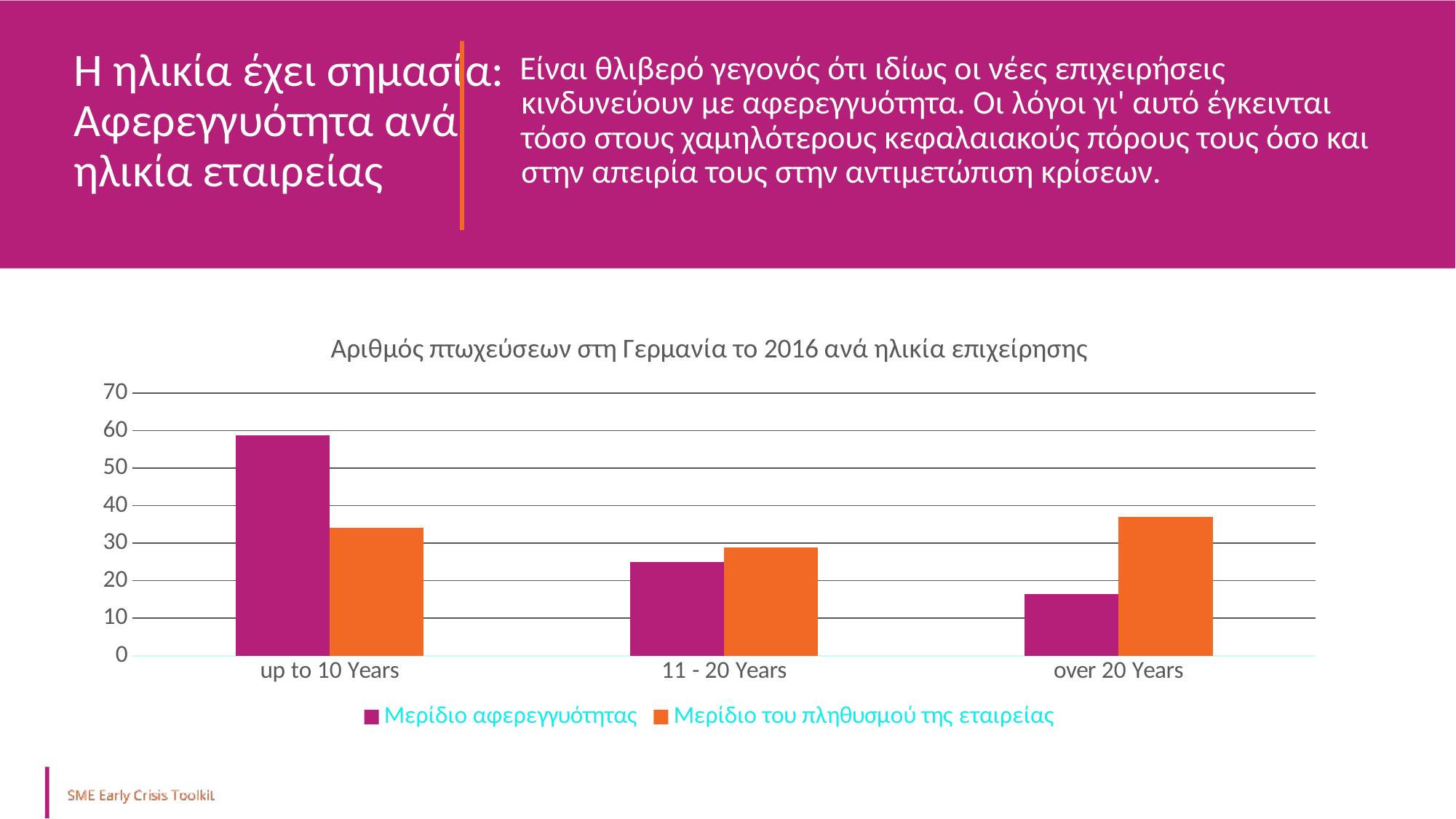
Which category has the lowest value for Μερίδιο του πληθυσμού της εταιρείας? 11 - 20 Years How many age categories are shown on the x axis? 3 What is the title of the chart? Αριθμός πτωχεύσεων στη Γερμανία το 2016 ανά ηλικία επιχείρησης What kind of chart is shown on the slide? bar chart Does the value for Μερίδιο αφερεγγυότητας rise or fall across the categories from up to 10 Years to over 20 Years? fall Is the value for Μερίδιο αφερεγγυότητας for up to 10 Years greater or less than 50? greater For over 20 Years, which series has the larger value: Μερίδιο αφερεγγυότητας or Μερίδιο του πληθυσμού της εταιρείας? Μερίδιο του πληθυσμού της εταιρείας For up to 10 Years, which series has the larger value: Μερίδιο αφερεγγυότητας or Μερίδιο του πληθυσμού της εταιρείας? Μερίδιο αφερεγγυότητας Which category has the lowest value for Μερίδιο αφερεγγυότητας? over 20 Years Which category has the highest value for Μερίδιο αφερεγγυότητας? up to 10 Years Which category has the highest value for Μερίδιο του πληθυσμού της εταιρείας? over 20 Years How many series does the legend list? 2